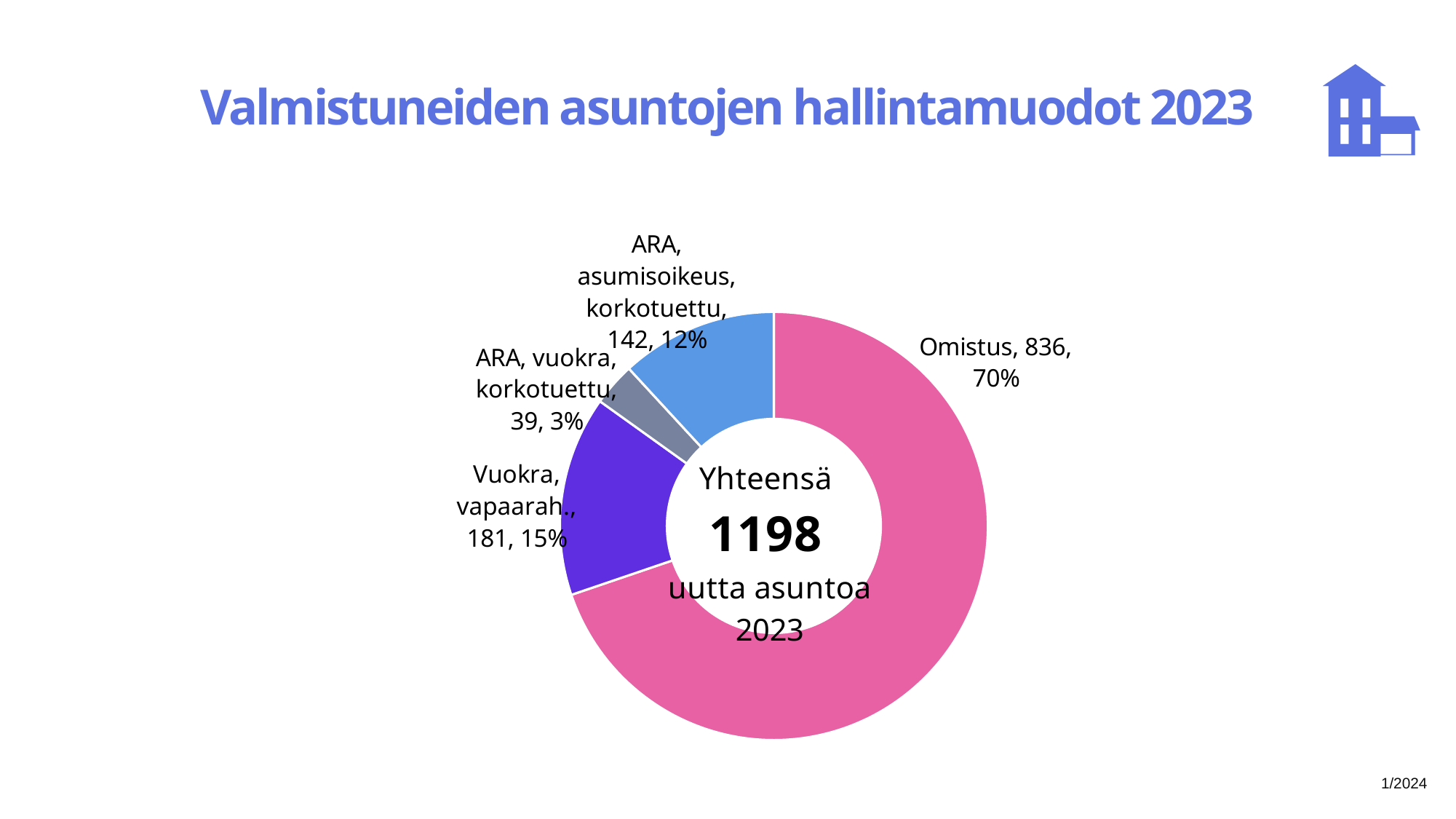
Which is larger, Vuokra, vapaarah. or ARA, asumisoikeus, korkotuettu? Vuokra, vapaarah. Which category has the largest slice? Omistus What share of the pie does ARA, asumisoikeus, korkotuettu represent? 12% What is the value for ARA, asumisoikeus, korkotuettu? 142 What is the difference between the values for Omistus and Vuokra, vapaarah.? 655 What kind of chart is shown on the slide? Pie chart (doughnut) What total is shown in the centre of the chart? 1198 What is the value for ARA, vuokra, korkotuettu? 39 What is the value for Vuokra, vapaarah.? 181 Which category has the smallest slice? ARA, vuokra, korkotuettu What share of the pie does Omistus represent? 70% What is the value for Omistus? 836